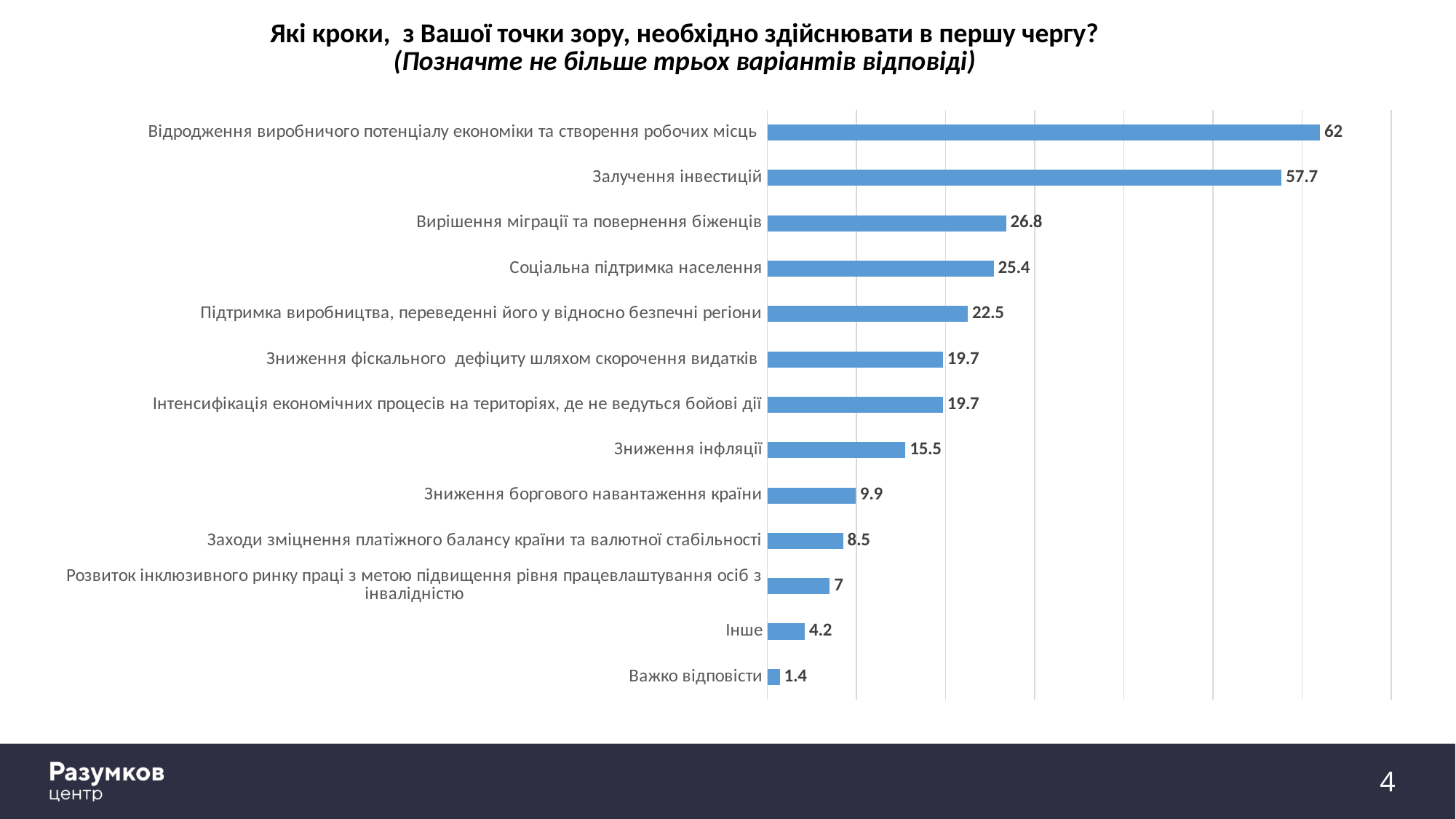
What kind of chart is shown on the slide? Bar chart Which category has the highest value? Відродження виробничого потенціалу економіки та створення робочих місць What is the difference between the values for "Відродження виробничого потенціалу економіки та створення робочих місць" and "Залучення інвестицій"? 4.3 What is the value for "Залучення інвестицій"? 57.7 Which category has the lowest value? Важко відповісти What colour are the bars in the chart? Blue What is the difference between the values for "Вирішення міграції та повернення біженців" and "Соціальна підтримка населення"? 1.4 Which is larger: the value for "Зниження боргового навантаження країни" or the value for "Заходи зміцнення платіжного балансу країни та валютної стабільності"? Зниження боргового навантаження країни What is the value for "Інше"? 4.2 How many categories are shown in the chart? 13 What is the value for "Соціальна підтримка населення"? 25.4 What is the value for "Зниження інфляції"? 15.5